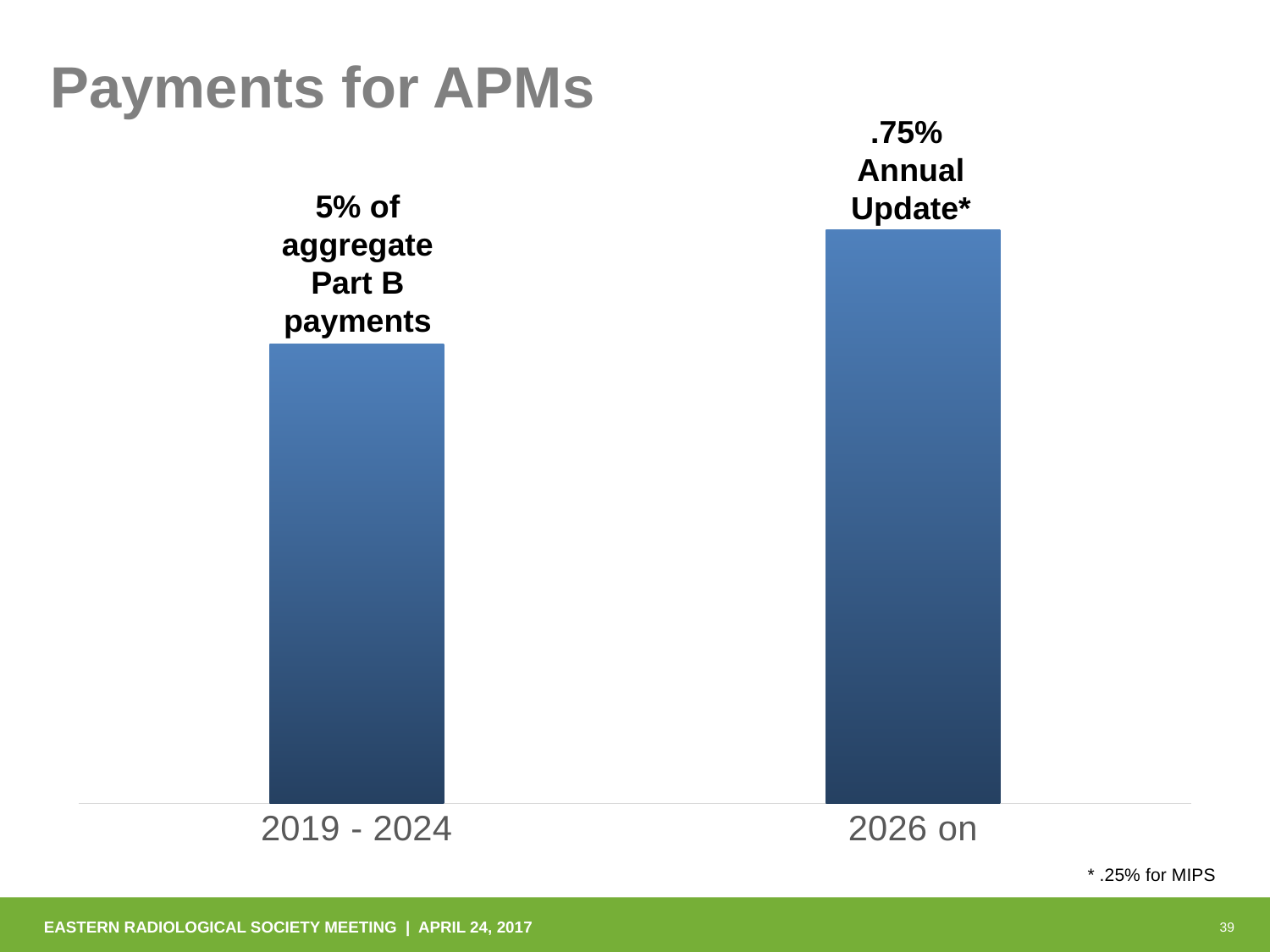
Which bar is drawn taller on the slide, 2019 - 2024 or 2026 on? 2026 on How many bars are plotted in the chart? 2 According to the footnote, what is the annual update for MIPS? .25% What annual update percentage is shown for 2026 on? .75% What percentage is shown for the 2019 - 2024 period? 5% What label is printed above the bar for 2026 on? .75% Annual Update* What is the title of the chart on the slide? Payments for APMs What label is printed above the bar for 2019 - 2024? 5% of aggregate Part B payments What kind of chart is shown on the slide? bar chart What are the two category labels on the x axis of the chart? 2019 - 2024 and 2026 on